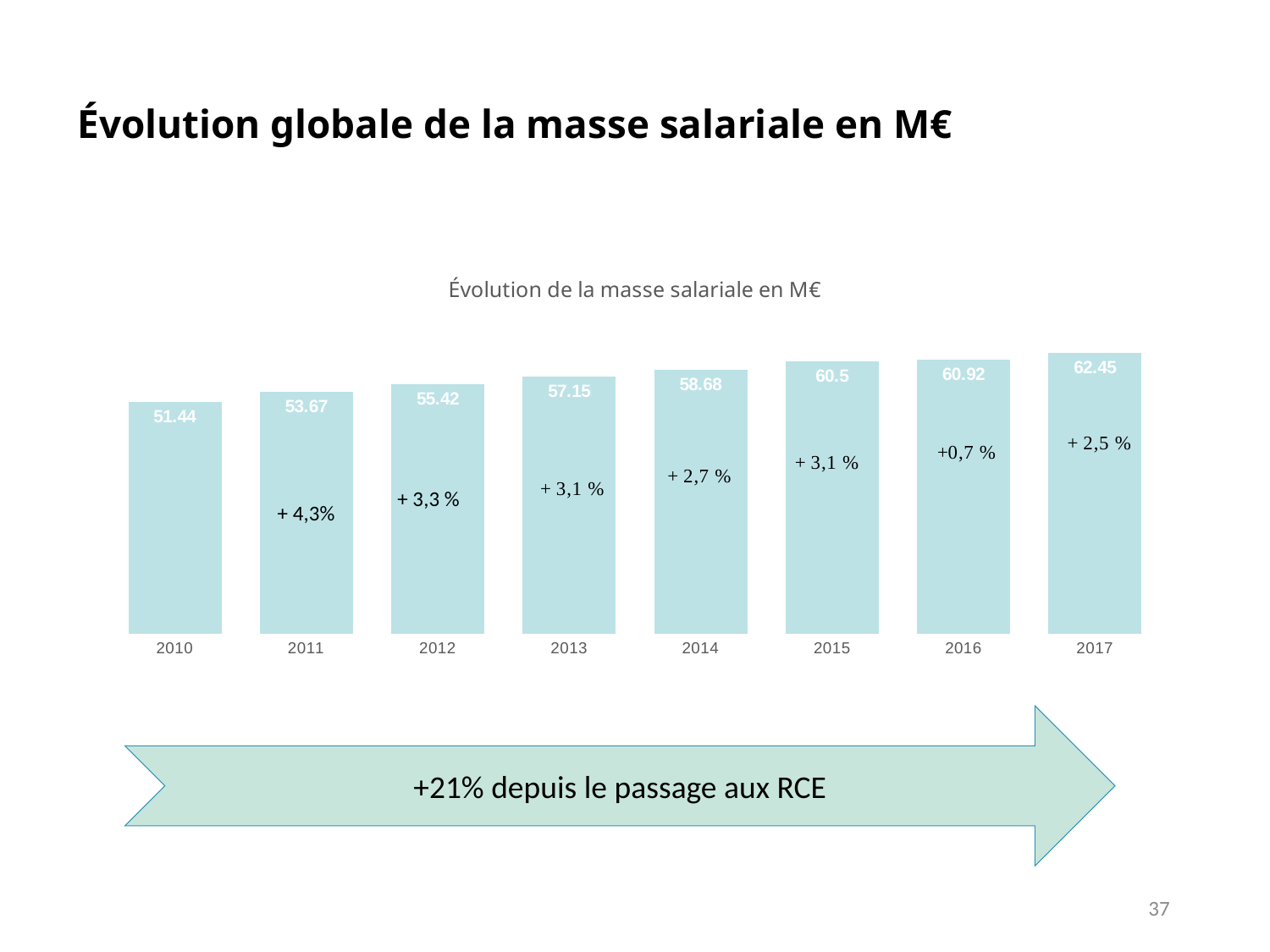
What is the title of the chart? Évolution de la masse salariale en M€ What is the value for 2017? 62.45 What is the difference between the values for 2017 and 2010? 11.01 Do the values rise or fall from 2010 to 2017? rise How many years are shown on the chart? 8 What is the value for 2010? 51.44 Which is larger, the value for 2012 or the value for 2013? 2013 What is the difference between the values for 2016 and 2015? 0.42 Which year has the highest value? 2017 What kind of chart is this? bar chart Which year has the lowest value? 2010 What is the value for 2014? 58.68